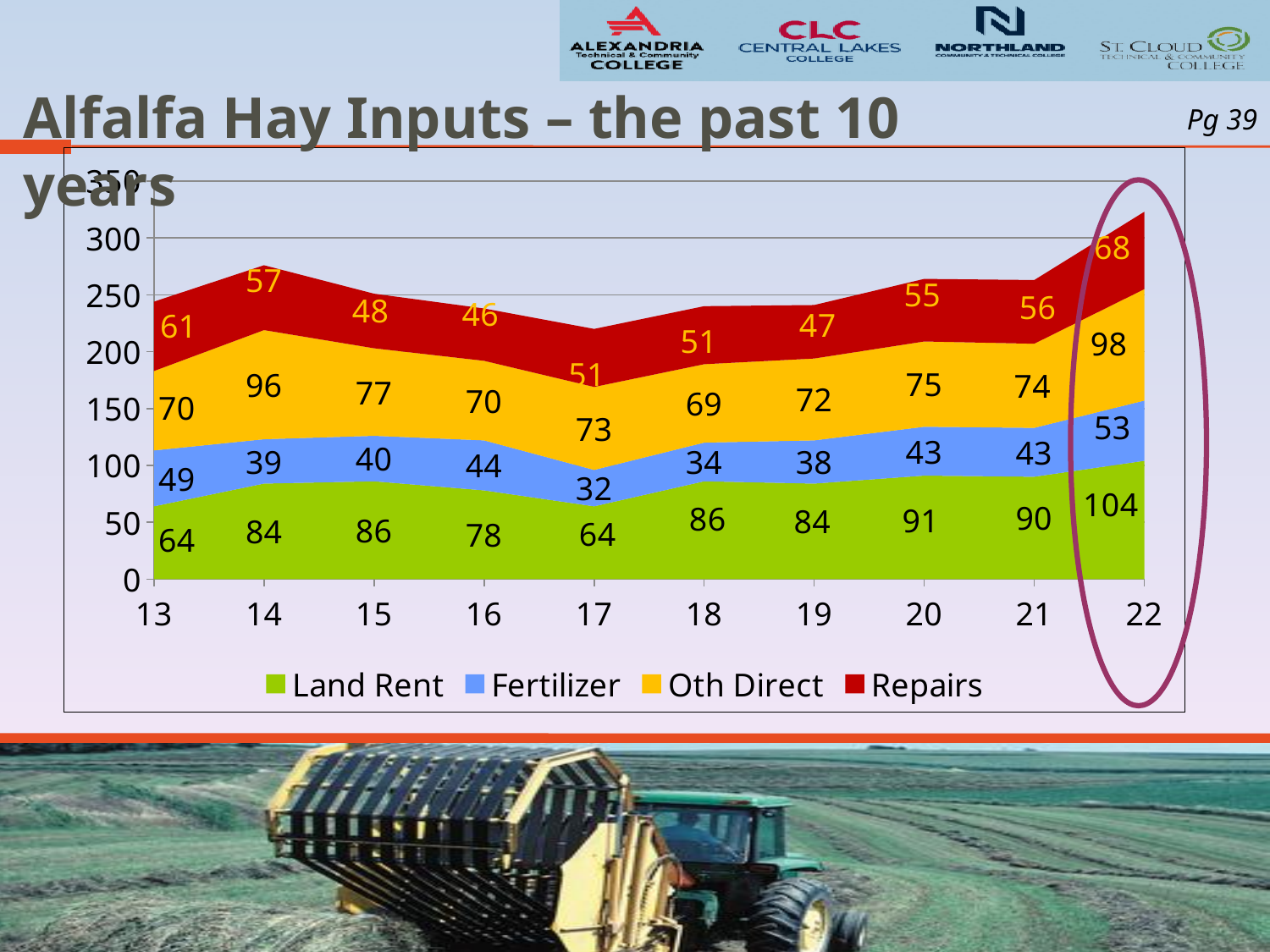
In which year is the Land Rent value highest? 22 How many series does the legend list? 4 How much higher is the Land Rent value in year 22 than in year 13? 40 What is the total of all four inputs for year 22? 323 Which year has the larger Oth Direct value, 14 or 15? 14 What kind of chart is shown on the slide? Stacked area chart What is the Land Rent value for year 22? 104 How many years are shown on the x axis? 10 What is the Repairs value for year 13? 61 What is the Oth Direct value for year 14? 96 In which year is the Fertilizer value lowest? 17 What is the Fertilizer value for year 17? 32